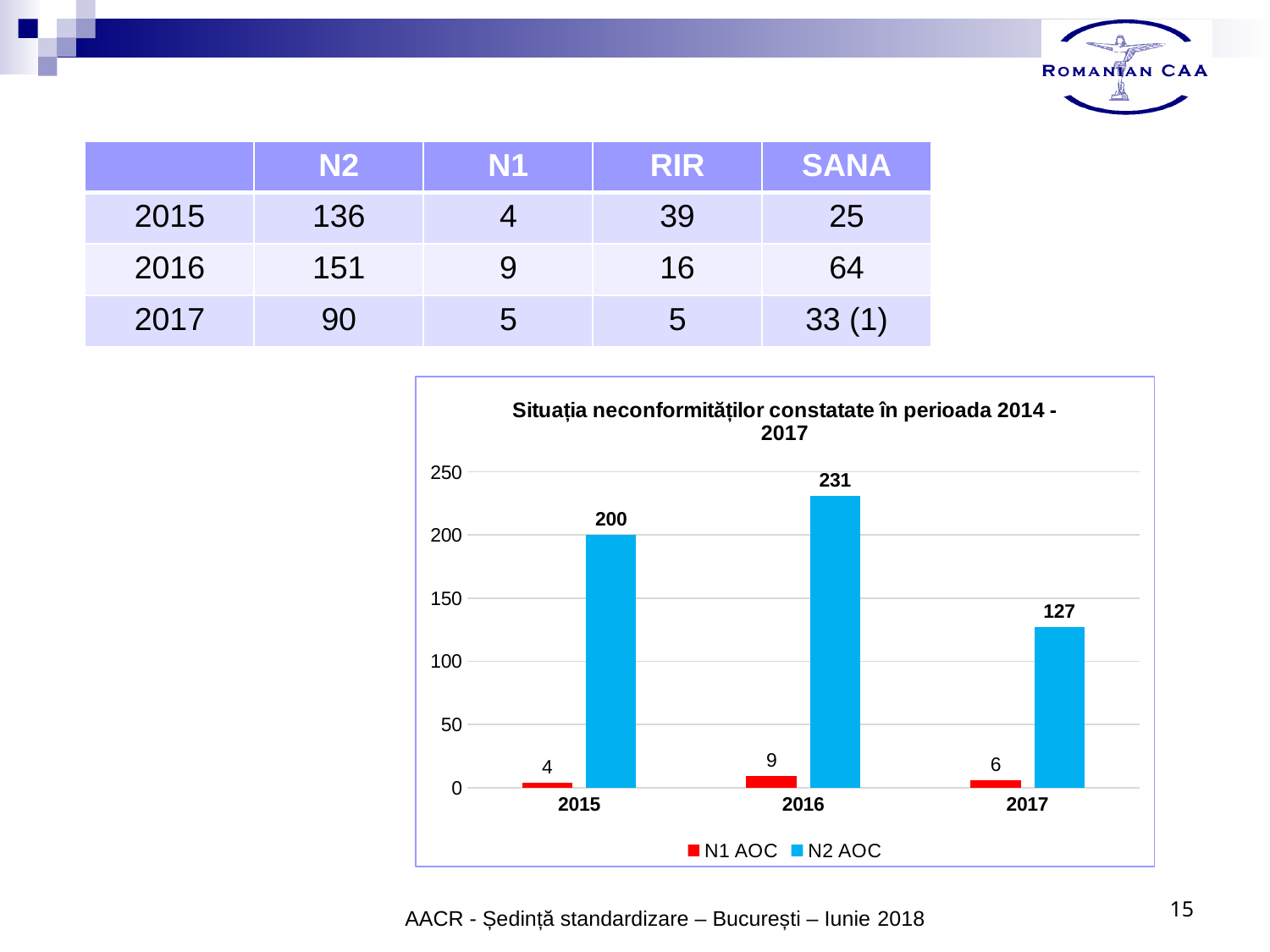
What is the difference between the N2 AOC values for 2016 and 2017? 104 Which is larger, the N1 AOC value for 2016 or for 2017? 2016 Which year has the lowest N1 AOC value? 2015 What is the value of N2 AOC for 2016? 231 What is the value of N1 AOC for 2017? 6 What is the value of N1 AOC for 2015? 4 How many series does the chart legend list? 2 What kind of chart is shown on the slide? bar chart How many years are shown on the x axis of the chart? 3 What is the value of N2 AOC for 2017? 127 Is the N2 AOC value for 2015 greater or less than 150? greater Which year has the highest N2 AOC value? 2016